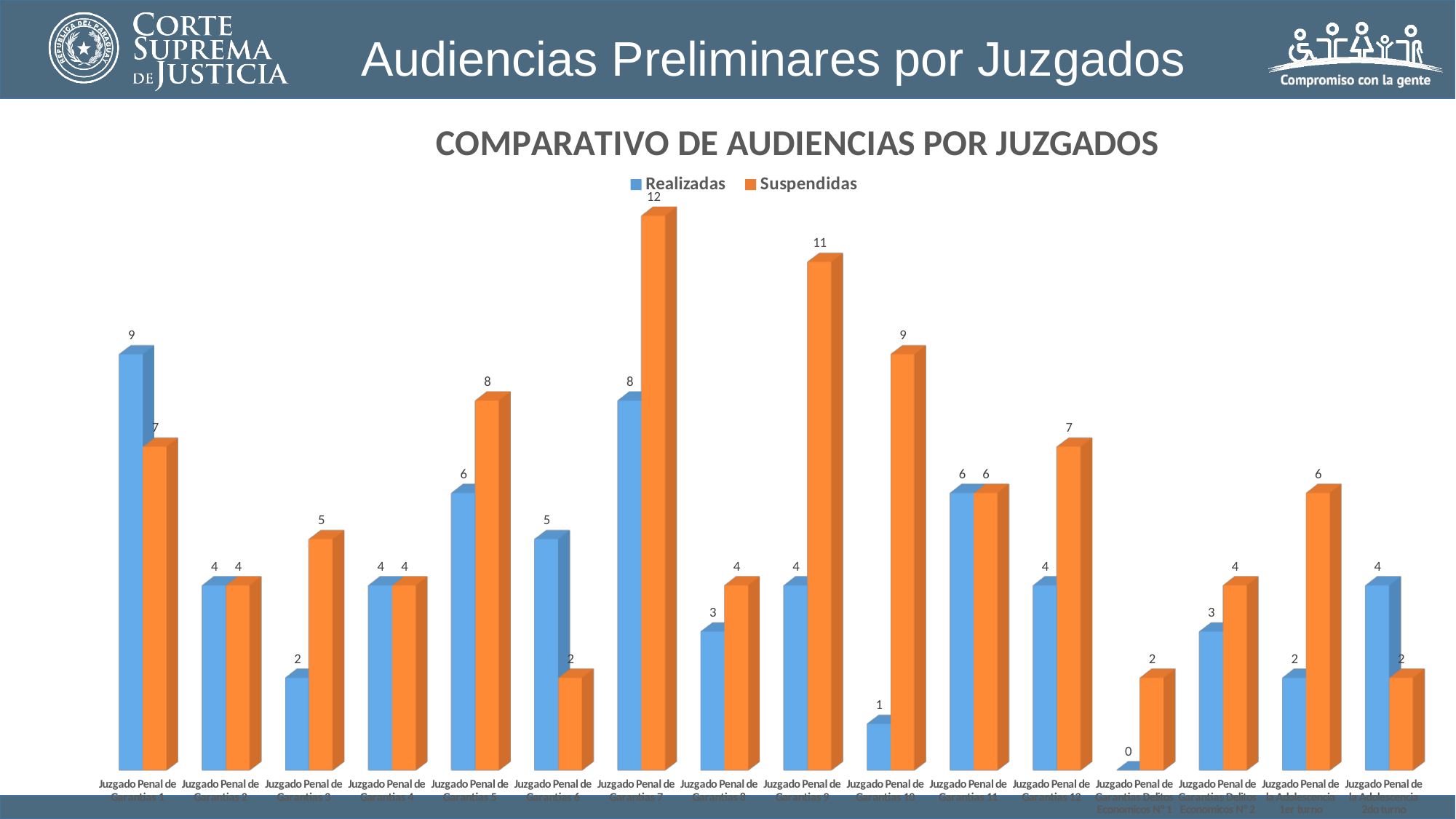
Which category has the highest Suspendidas value? Juzgado Penal de Garantias 7 For Juzgado Penal de Garantias 6, which is larger, Realizadas or Suspendidas? Realizadas What is the Suspendidas value for Juzgado Penal de Garantias 9? 11 What is the title of the chart? COMPARATIVO DE AUDIENCIAS POR JUZGADOS Which category has the lowest Realizadas value? Juzgado Penal de Garantias Delitos Economicos N° 1 How many categories are shown on the x axis? 16 What is the Realizadas value for Juzgado Penal de Garantias 11? 6 What is the difference between the Realizadas values for Juzgado Penal de Garantias 1 and Juzgado Penal de Garantias 3? 7 What is the difference between the Suspendidas and Realizadas values for Juzgado Penal de Garantias 10? 8 What is the Realizadas value for Juzgado Penal de Garantias 1? 9 How many series does the legend list? 2 What type of chart is shown on the slide? bar chart